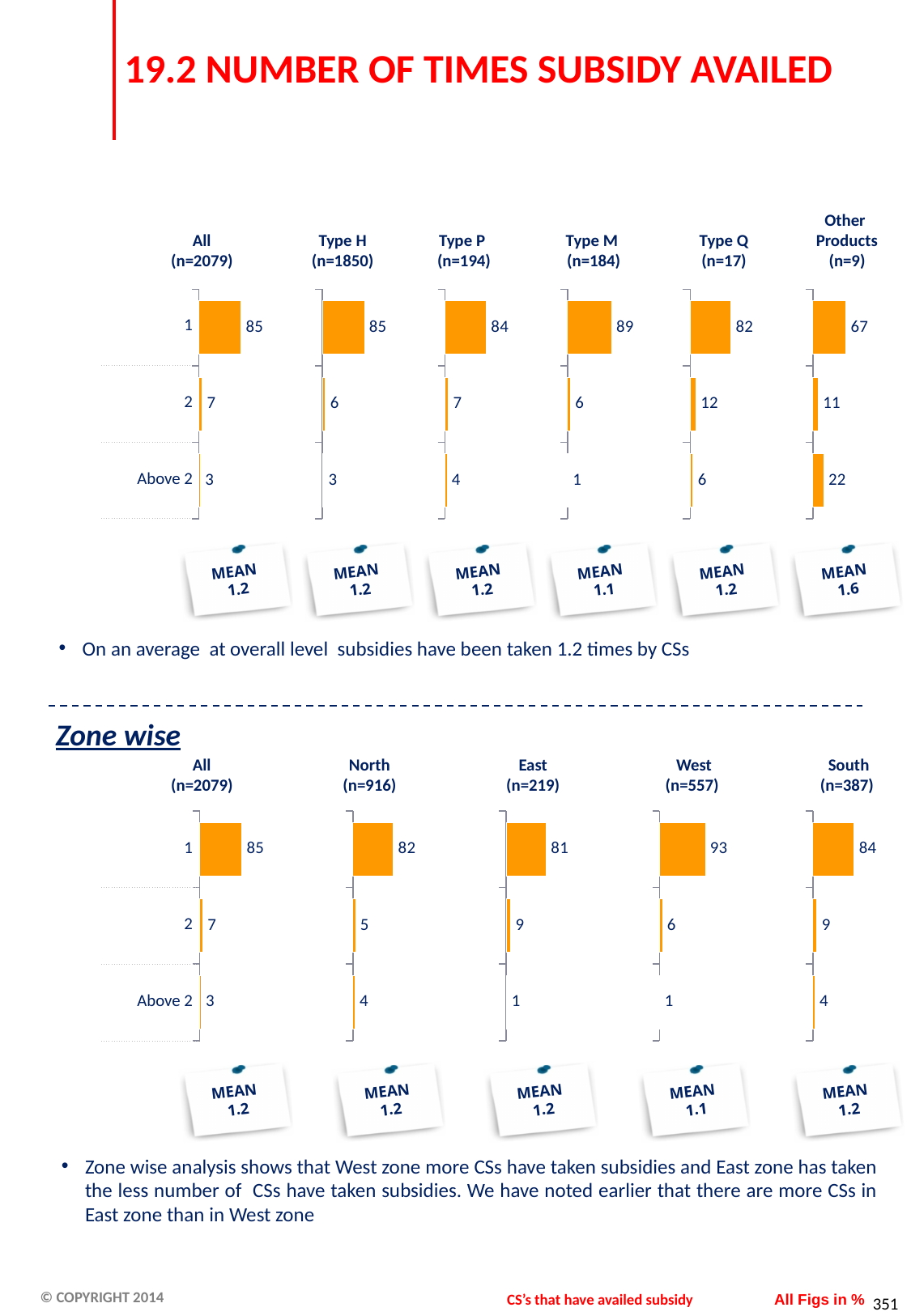
How many categories are shown in each of the Zone wise bar charts? 3 In the top set of charts, what is the difference between the '1' value for Type M and the '1' value for Type Q? 7 In the top set of charts, which product type has the lowest value for '1'? Other Products In the Zone wise charts, what is the value for '2' in the East (n=219) chart? 9 What type of chart is used to show the number of times subsidy availed? Bar chart In the Zone wise charts, what is the value for '1' in the West (n=557) chart? 93 In the top set of charts, which is larger: the '2' value for Type Q or the '2' value for Type H? Type Q In the Zone wise charts, which zone has the highest value for '1'? West In the Zone wise charts, what is the difference between the '1' value for West and the '1' value for East? 12 What is the MEAN shown below the Other Products chart in the top set? 1.6 In the top set of charts (by product type), what is the value for '1' in the Type M (n=184) chart? 89 In the top set of charts, what is the value for 'Above 2' in the Other Products (n=9) chart? 22